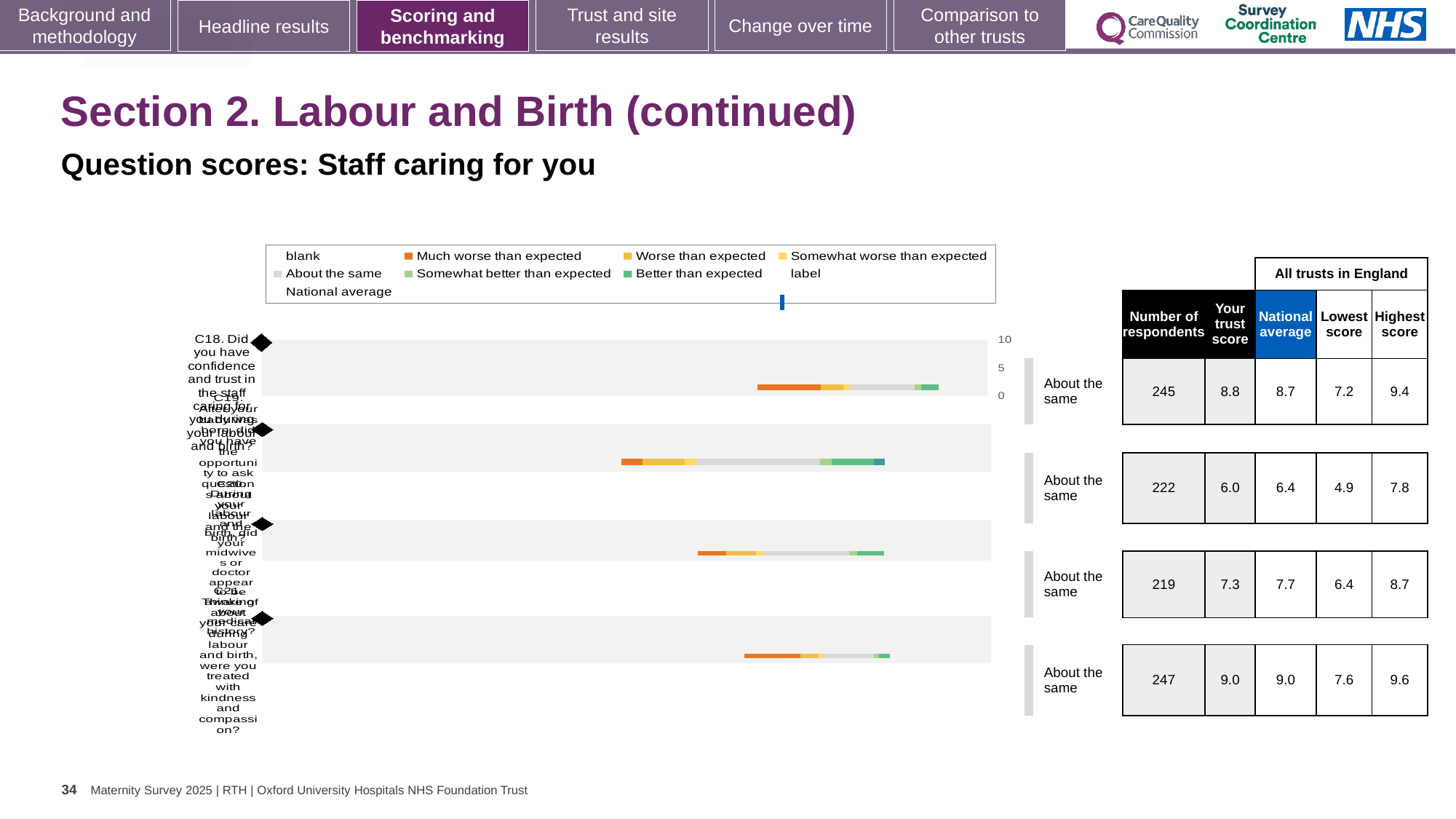
In the first row of the table, what is the difference between the highest score and the lowest score? 2.2 Which row of the table has the lowest 'Your trust score'? second row (C19), 6.0 What colour does the legend use for 'Much worse than expected'? orange In the table, what is the national average in the third row (C20)? 7.7 In the table, what is the highest score in the fourth row (C21)? 9.6 What kind of chart is shown on the slide? bar chart In the table, what is the number of respondents in the first row (C18)? 245 How many question bars are plotted in the chart? 4 What colour does the legend use for 'Better than expected'? green In the second row of the table, which is larger: 'Your trust score' or the national average? National average In the table, what is 'Your trust score' in the second row (C19)? 6.0 Which row of the table has the highest 'Your trust score'? fourth row (C21), 9.0